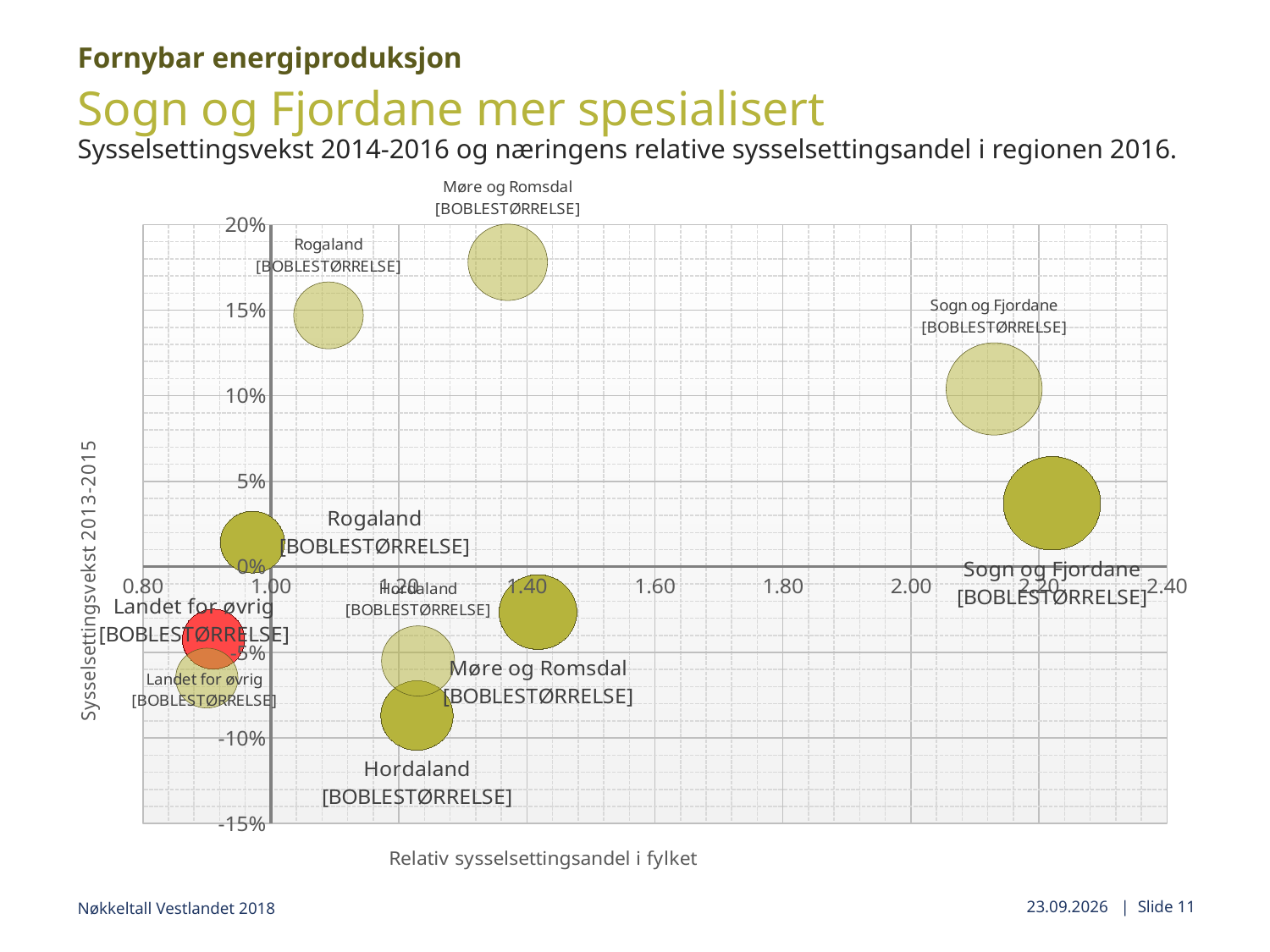
Which region's dark-coloured bubble is positioned lowest on the vertical axis? Hordaland Which region's bubbles lie furthest to the right on the horizontal axis? Sogn og Fjordane Is the horizontal-axis value of the light-coloured Rogaland bubble greater or less than 1.20? less How many different regions are labelled in the chart? 5 Is the horizontal-axis value of the dark-coloured Sogn og Fjordane bubble greater or less than 2.00? greater Is the vertical-axis value of the dark-coloured Hordaland bubble greater or less than -5%? less Which has the higher vertical-axis value: the light-coloured Møre og Romsdal bubble or the light-coloured Rogaland bubble? Møre og Romsdal What kind of chart is shown on the slide? Bubble chart What is the title of the vertical axis of the chart? Sysselsettingsvekst 2013-2015 What is the title of the horizontal axis of the chart? Relativ sysselsettingsandel i fylket Which region's light-coloured bubble is positioned highest on the vertical axis? Møre og Romsdal